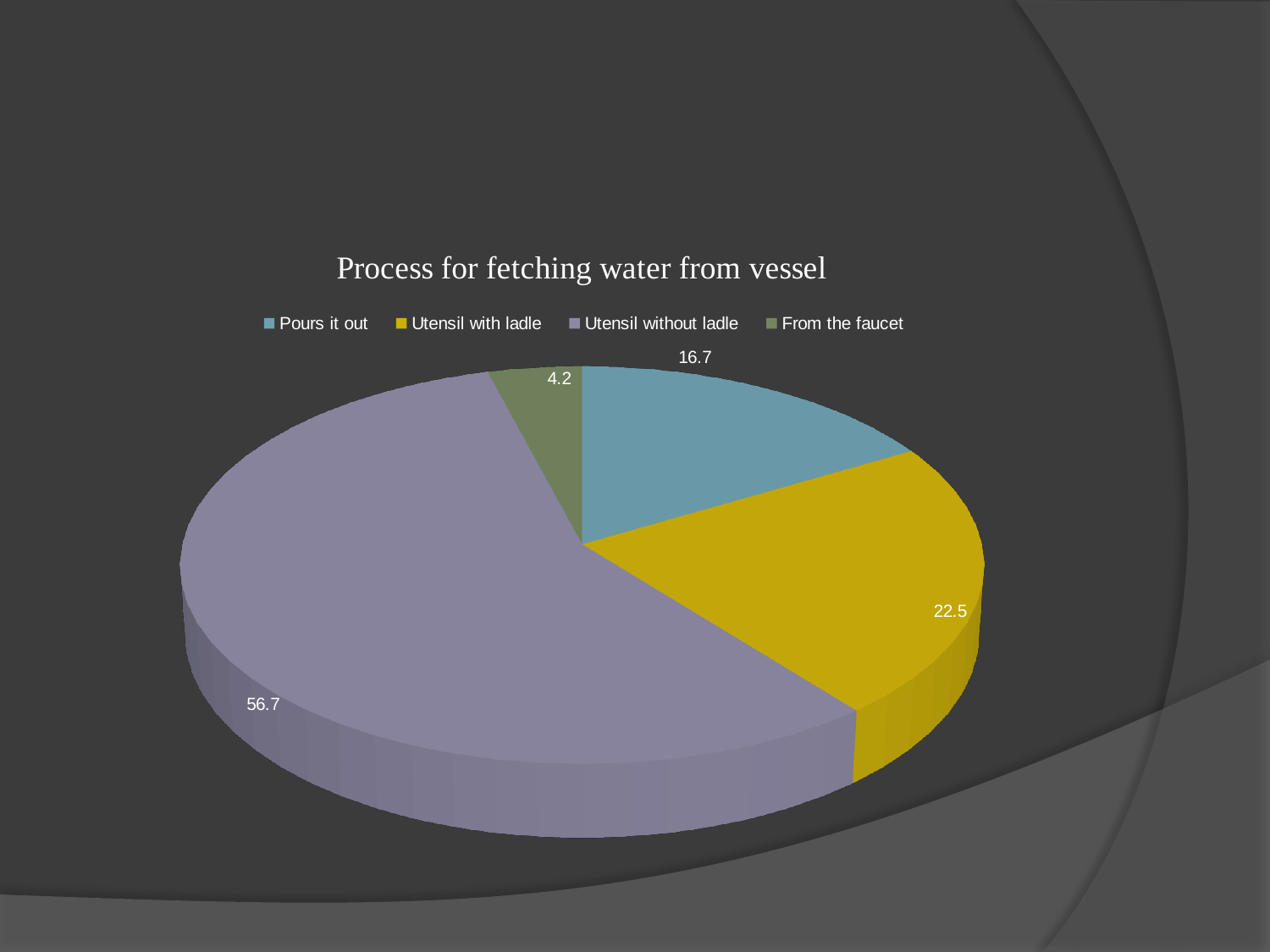
What is the value for Utensil with ladle? 22.5 What is the difference between the values for Utensil without ladle and Utensil with ladle? 34.2 What is the title of the chart? Process for fetching water from vessel What kind of chart is shown on the slide? Pie chart How many categories does the pie chart show? 4 Which category has the largest slice? Utensil without ladle Which is larger, the value for Pours it out or the value for Utensil with ladle? Utensil with ladle Which category has the smallest slice? From the faucet What is the value for From the faucet? 4.2 What is the value for Pours it out? 16.7 What colour is the slice for Utensil with ladle? Yellow What is the value for Utensil without ladle? 56.7